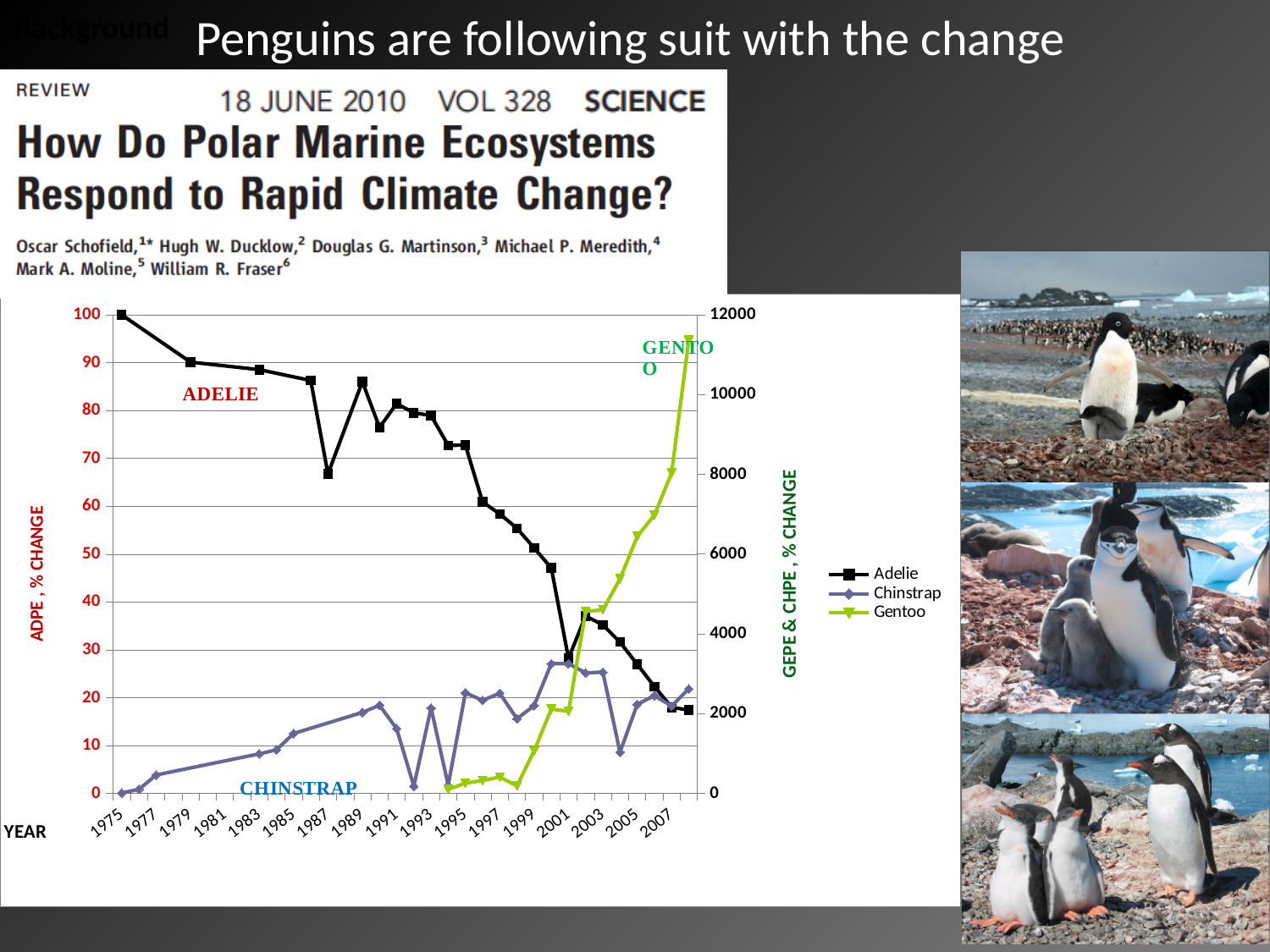
Is the Adelie value for 1979 greater or less than 80? greater In which year is the Gentoo series at its highest? 2008 What kind of chart is shown on the slide? line chart What is the label of the right-hand vertical axis? GEPE & CHPE , % CHANGE Which series are listed in the chart legend? Adelie, Chinstrap, Gentoo Does the Adelie series generally rise or fall from 1975 to 2007? fall How many series does the chart legend list? 3 Is the Gentoo value for 2007 greater or less than 10000? less In which year is the Adelie series at its highest? 1975 What is the Adelie value in 1975? 100 Is the Gentoo value for 2003 greater or less than 6000? less Does the Gentoo series generally rise or fall from 1995 to 2007? rise